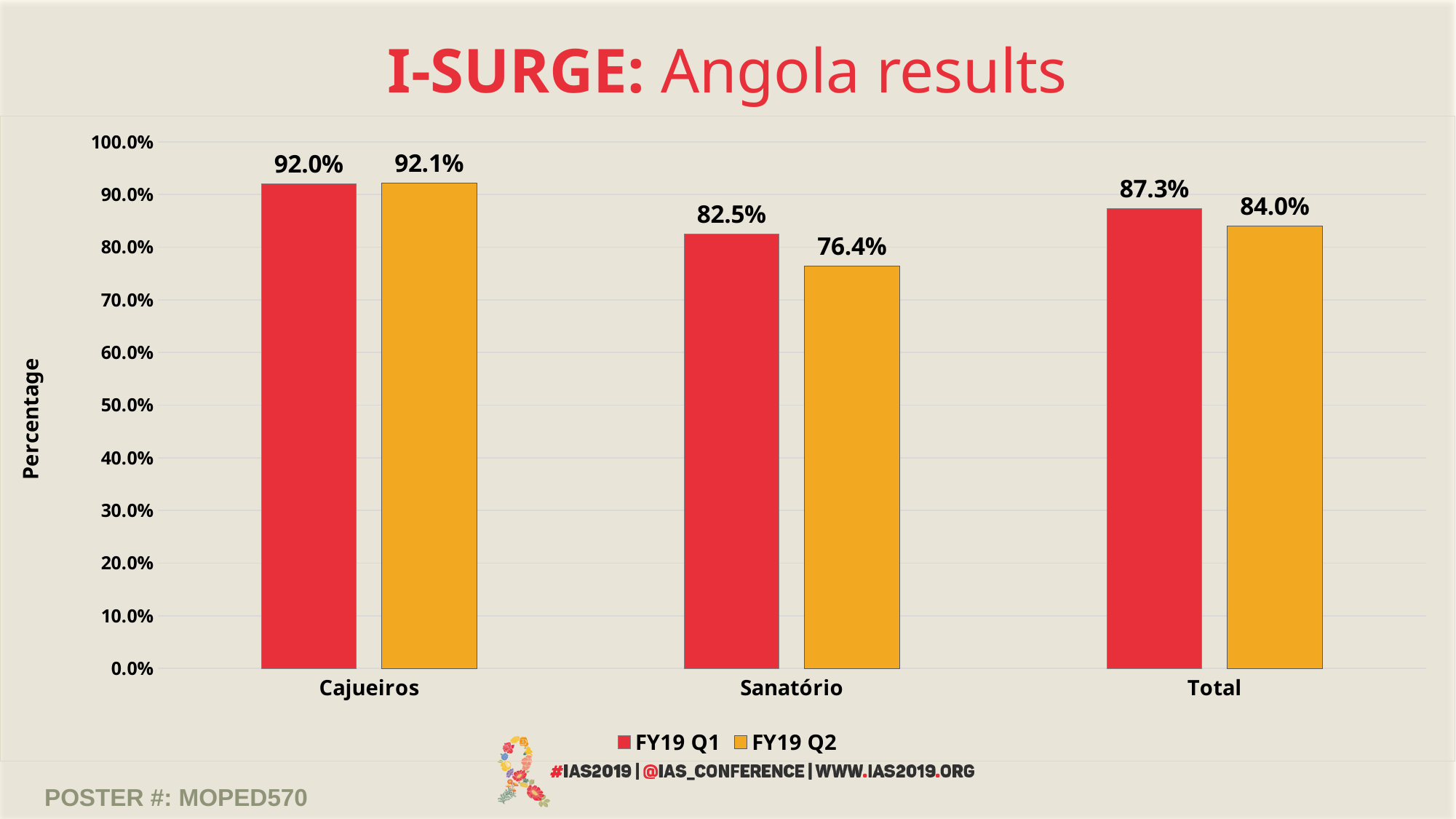
Which is larger for Sanatório, the FY19 Q1 value or the FY19 Q2 value? FY19 Q1 What is the FY19 Q1 value for Total? 87.3% How many categories are shown on the x axis? 3 What is the FY19 Q2 value for Sanatório? 76.4% Which category has the lowest FY19 Q2 value? Sanatório What is the difference between the FY19 Q1 and FY19 Q2 values for Sanatório? 6.1% How many series does the legend list? 2 What type of chart is shown on the slide? Bar chart What is the difference between the FY19 Q1 and FY19 Q2 values for Total? 3.3% What is the FY19 Q2 value for Cajueiros? 92.1% Which category has the highest FY19 Q1 value? Cajueiros What is the FY19 Q1 value for Cajueiros? 92.0%